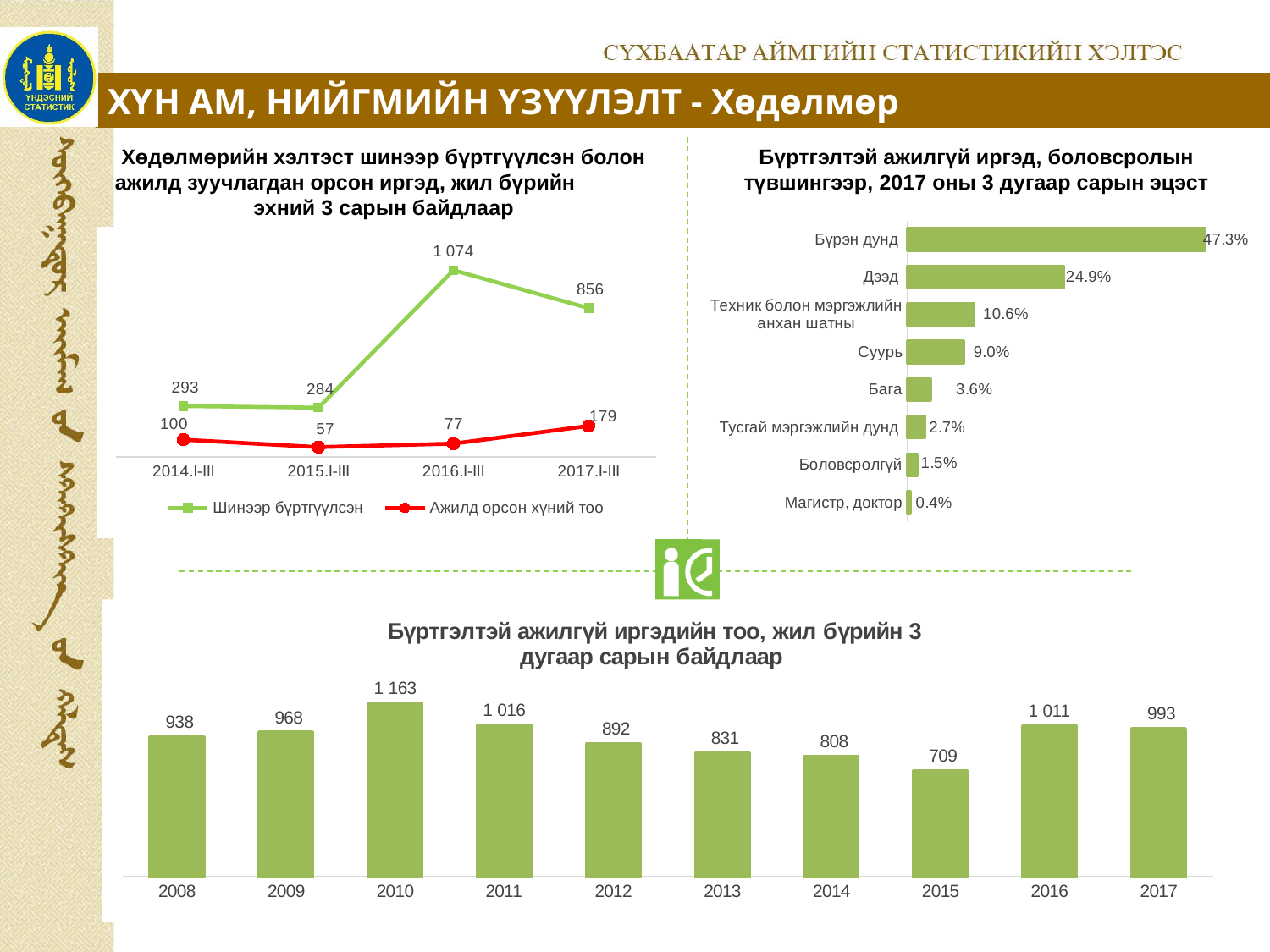
What type of chart is the top-right chart (Бүртгэлтэй ажилгүй иргэд, боловсролын түвшингээр)? Bar chart In the bottom chart (Бүртгэлтэй ажилгүй иргэдийн тоо), what is the difference between the values for 2016 and 2017? 18 In the bottom chart (Бүртгэлтэй ажилгүй иргэдийн тоо), how many years are shown? 10 In the top-left line chart, how many series does the legend list? 2 In the bottom chart (Бүртгэлтэй ажилгүй иргэдийн тоо), which year has the lowest value? 2015 In the top-right chart (Бүртгэлтэй ажилгүй иргэд, боловсролын түвшингээр), which category has the highest value? Бүрэн дунд In the top-right chart (Бүртгэлтэй ажилгүй иргэд, боловсролын түвшингээр), how many education-level categories are shown? 8 In the bottom chart (Бүртгэлтэй ажилгүй иргэдийн тоо), what is the value for 2010? 1 163 In the bottom chart (Бүртгэлтэй ажилгүй иргэдийн тоо), which is larger, the value for 2009 or the value for 2012? 2009 In the top-left line chart, what is the value of Шинээр бүртгүүлсэн for 2016.I-III? 1 074 In the top-left line chart, what is the difference between Шинээр бүртгүүлсэн and Ажилд орсон хүний тоо for 2017.I-III? 677 In the top-right chart (Бүртгэлтэй ажилгүй иргэд, боловсролын түвшингээр), what is the value for Дээд? 24.9%